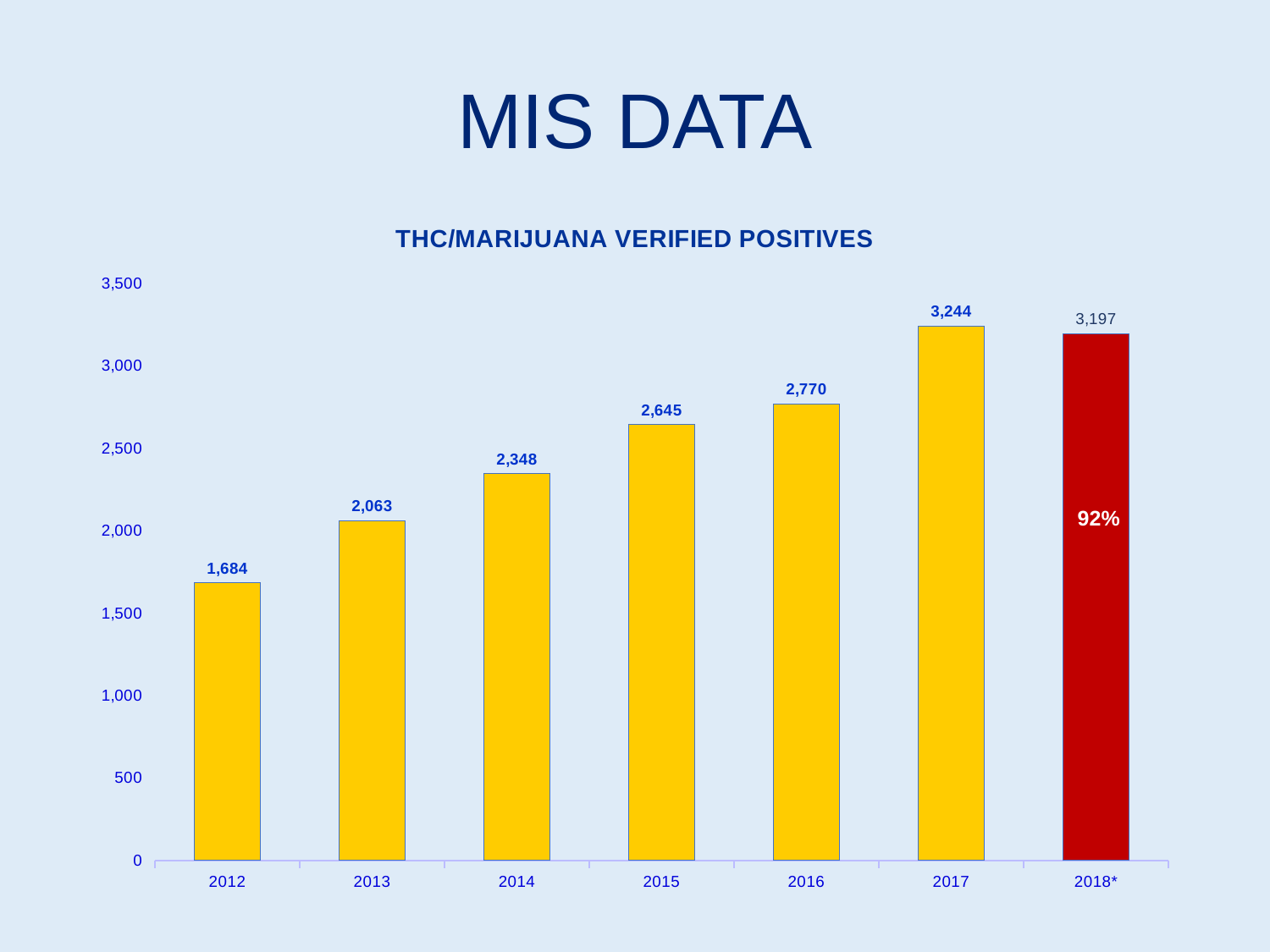
What is the value for 2012 in the THC/Marijuana Verified Positives chart? 1,684 Do the values rise or fall from 2012 to 2017 in the THC/Marijuana Verified Positives chart? rise How many years are shown on the x axis of the THC/Marijuana Verified Positives chart? 7 What is the value for 2016 in the THC/Marijuana Verified Positives chart? 2,770 What kind of chart is the THC/Marijuana Verified Positives chart? bar chart Which is larger in the THC/Marijuana Verified Positives chart, the value for 2015 or the value for 2014? 2015 What is the value for 2018* in the THC/Marijuana Verified Positives chart? 3,197 What is the difference between the 2013 and 2012 values in the THC/Marijuana Verified Positives chart? 379 Is the value for 2016 greater or less than 3,000 in the THC/Marijuana Verified Positives chart? less Which year has the lowest value in the THC/Marijuana Verified Positives chart? 2012 What is the difference between the 2017 and 2018* values in the THC/Marijuana Verified Positives chart? 47 Which year has the highest value in the THC/Marijuana Verified Positives chart? 2017